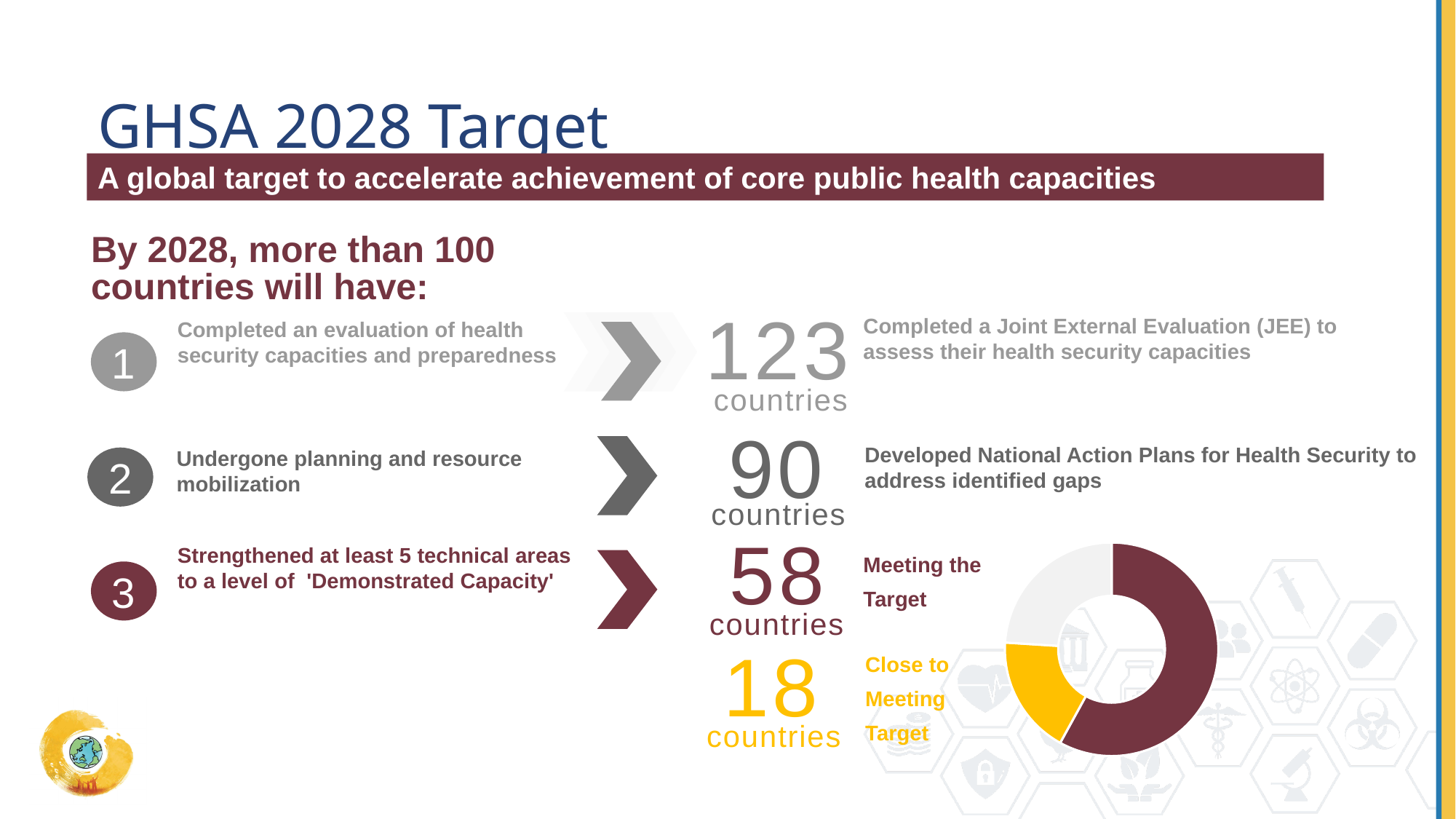
In the donut chart, what colour represents the 'Meeting the Target' segment? Maroon In the donut chart, which segment is the largest? Meeting the Target Is the number of countries 'Close to Meeting Target' in the donut chart greater or less than 20? less In the donut chart, how many countries are labelled as 'Close to Meeting Target'? 18 countries In the donut chart, what colour represents the 'Close to Meeting Target' segment? Yellow In the donut chart, how many countries are labelled as 'Meeting the Target'? 58 countries What kind of chart is shown at the bottom right of the slide? Pie chart (donut) Is the number of countries 'Meeting the Target' in the donut chart greater or less than 50? greater In the donut chart, which labelled category has the larger value: 'Meeting the Target' or 'Close to Meeting Target'? Meeting the Target How many segments does the donut chart have? 3 In the donut chart, what is the difference between the number of countries 'Meeting the Target' and those 'Close to Meeting Target'? 40